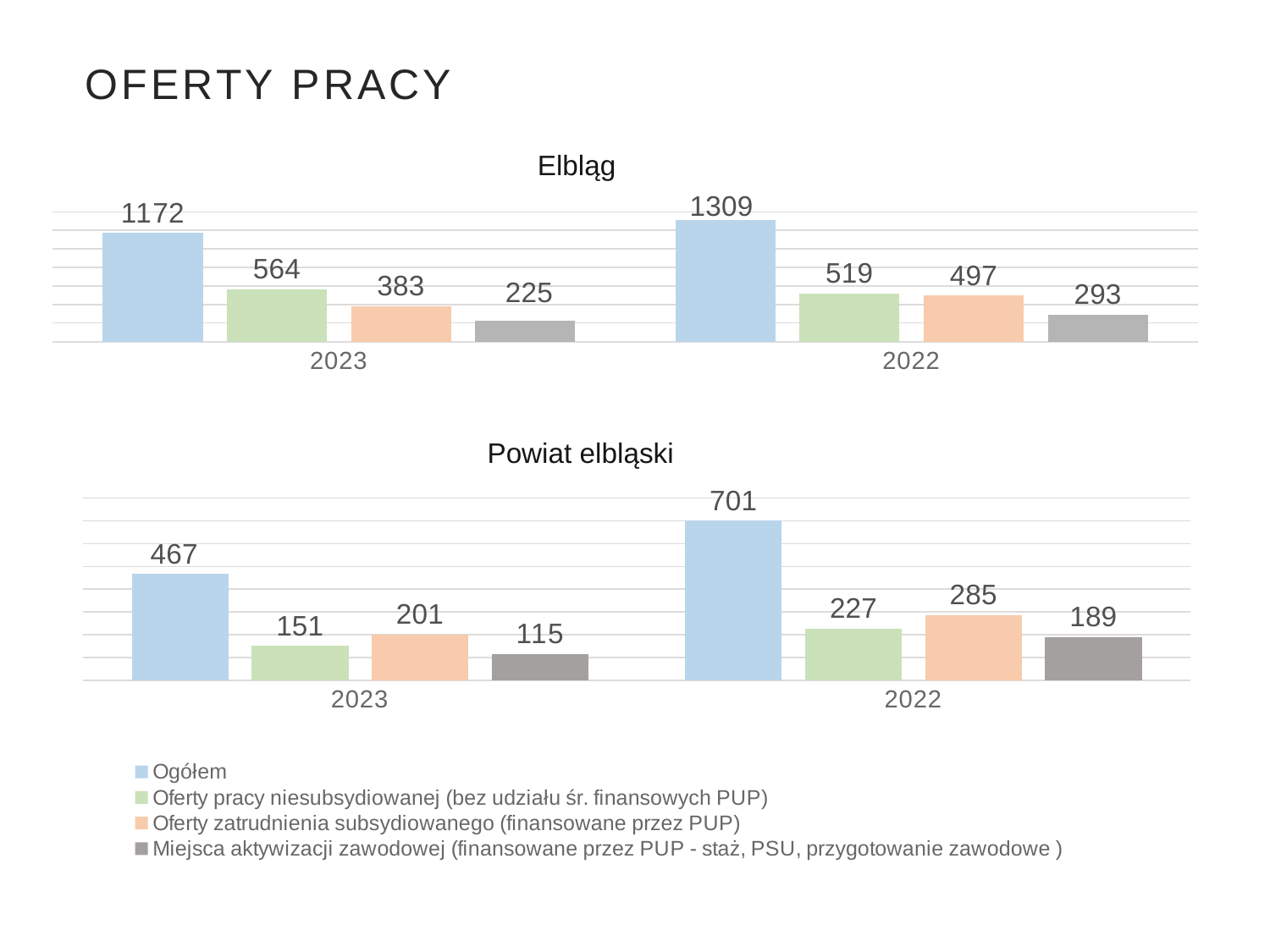
What colour represents the Ogółem series in the charts? Light blue In the Elbląg chart, which series has the lowest value in 2023? Miejsca aktywizacji zawodowej (finansowane przez PUP - staż, PSU, przygotowanie zawodowe ) In the Elbląg chart, what is the value of Oferty zatrudnienia subsydiowanego (finansowane przez PUP) for 2022? 497 How many series does the legend list? 4 In the Powiat elbląski chart, which year has the higher Ogółem value? 2022 In the Elbląg chart, what is the value of Ogółem for 2023? 1172 What kind of chart is the Powiat elbląski chart? Bar chart In the Powiat elbląski chart, what is the value of Ogółem for 2022? 701 In the Powiat elbląski chart, what is the difference between Oferty zatrudnienia subsydiowanego in 2022 and 2023? 84 In the Elbląg chart, is Oferty pracy niesubsydiowanej larger in 2023 or 2022? 2023 In the Powiat elbląski chart, what is the value of Miejsca aktywizacji zawodowej for 2023? 115 In the Elbląg chart, what is the difference between the Ogółem values for 2022 and 2023? 137